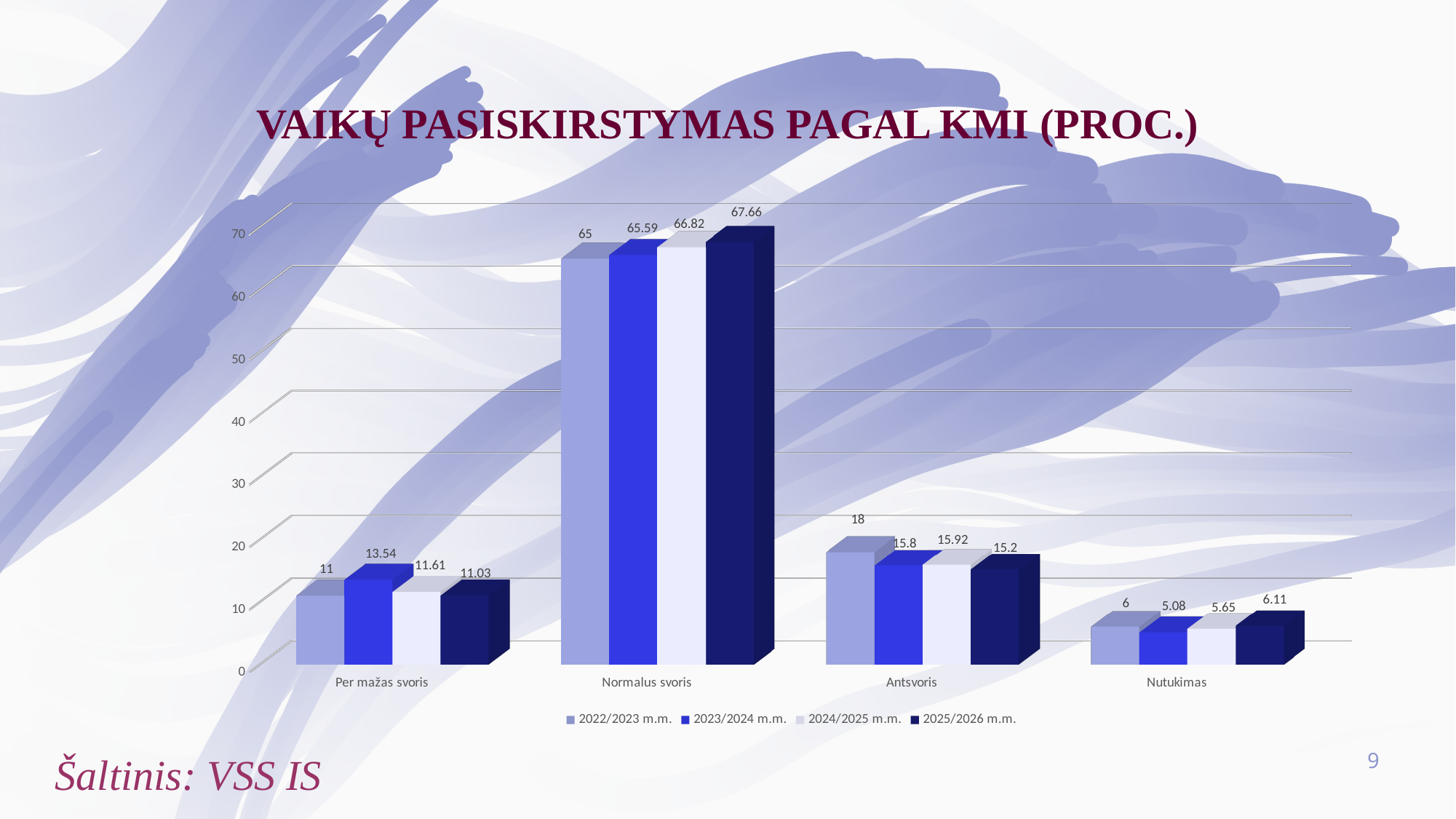
How many categories are shown on the x axis? 4 What is the value for Antsvoris in the 2022/2023 m.m. series? 18 How many series does the legend list? 4 Which category has the lowest value in the 2025/2026 m.m. series? Nutukimas Which category has the highest value in the 2022/2023 m.m. series? Normalus svoris What is the difference between the 2025/2026 m.m. and 2022/2023 m.m. values for Normalus svoris? 2.66 What is the value for Nutukimas in the 2023/2024 m.m. series? 5.08 Do the values for Normalus svoris rise or fall from 2022/2023 m.m. to 2025/2026 m.m.? Rise Which is larger for Per mažas svoris: the 2023/2024 m.m. value or the 2025/2026 m.m. value? 2023/2024 m.m. What is the value for Per mažas svoris in the 2024/2025 m.m. series? 11.61 What is the value for Normalus svoris in the 2025/2026 m.m. series? 67.66 What kind of chart is shown on the slide? Bar chart